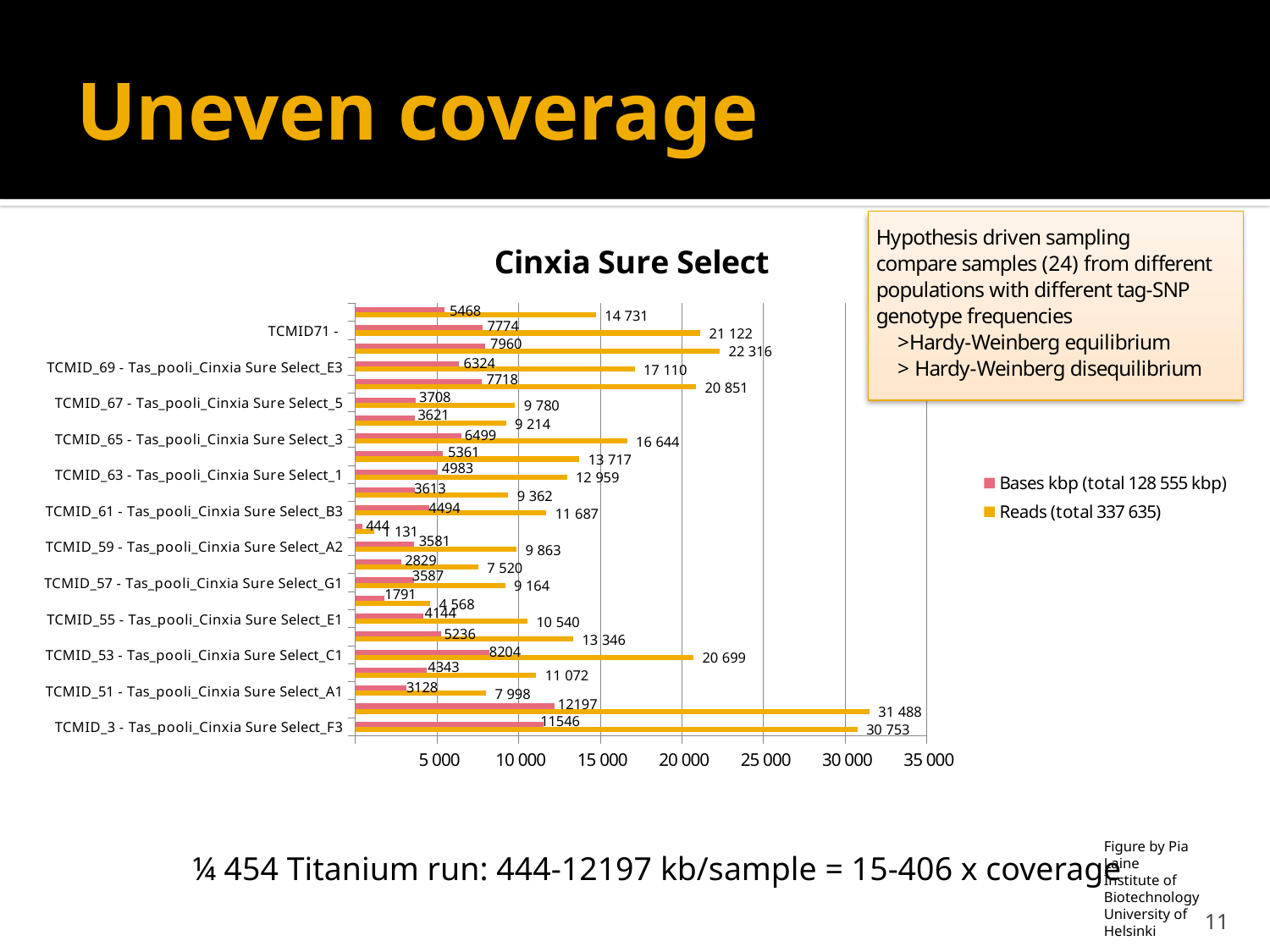
What is the smallest Bases kbp value shown in the chart? 444 What is the Bases kbp value for TCMID_69 - Tas_pooli_Cinxia Sure Select_E3? 6324 What type of chart is shown on the slide? bar chart What is the largest Reads value shown in the chart? 31 488 What is the Reads value for TCMID_65 - Tas_pooli_Cinxia Sure Select_3? 16 644 What is the title of the chart? Cinxia Sure Select How many series does the legend list? 2 What is the Reads value for TCMID_3 - Tas_pooli_Cinxia Sure Select_F3? 30 753 Is the Reads value for TCMID_53 - Tas_pooli_Cinxia Sure Select_C1 greater or less than 20 000? greater What is the Bases kbp value for TCMID_3 - Tas_pooli_Cinxia Sure Select_F3? 11546 What is the difference between the Reads value and the Bases kbp value for TCMID_3 - Tas_pooli_Cinxia Sure Select_F3? 19207 Which has a larger Reads value: TCMID_65 - Tas_pooli_Cinxia Sure Select_3 or TCMID_67 - Tas_pooli_Cinxia Sure Select_5? TCMID_65 - Tas_pooli_Cinxia Sure Select_3